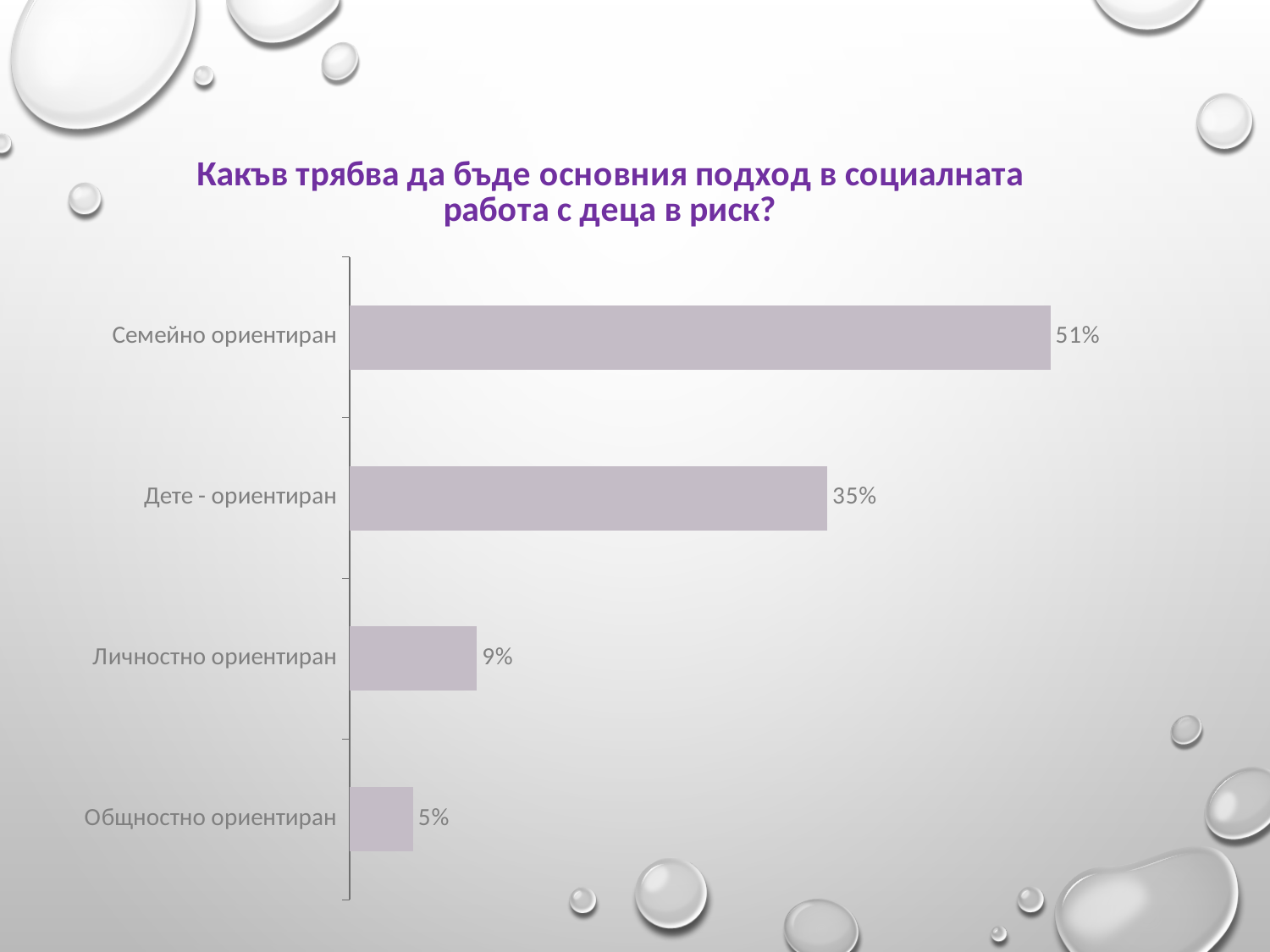
What is the difference between the values for Личностно ориентиран and Общностно ориентиран? 4% What is the value for Семейно ориентиран? 51% Which category has the highest value? Семейно ориентиран What is the value for Личностно ориентиран? 9% How many categories are shown in the chart? 4 What is the value for Общностно ориентиран? 5% What is the value for Дете - ориентиран? 35% What kind of chart is shown on the slide? Bar chart Which is larger, the value for Дете - ориентиран or the value for Личностно ориентиран? Дете - ориентиран What is the difference between the values for Семейно ориентиран and Дете - ориентиран? 16% What is the title of the chart? Какъв трябва да бъде основния подход в социалната работа с деца в риск? Which category has the lowest value? Общностно ориентиран